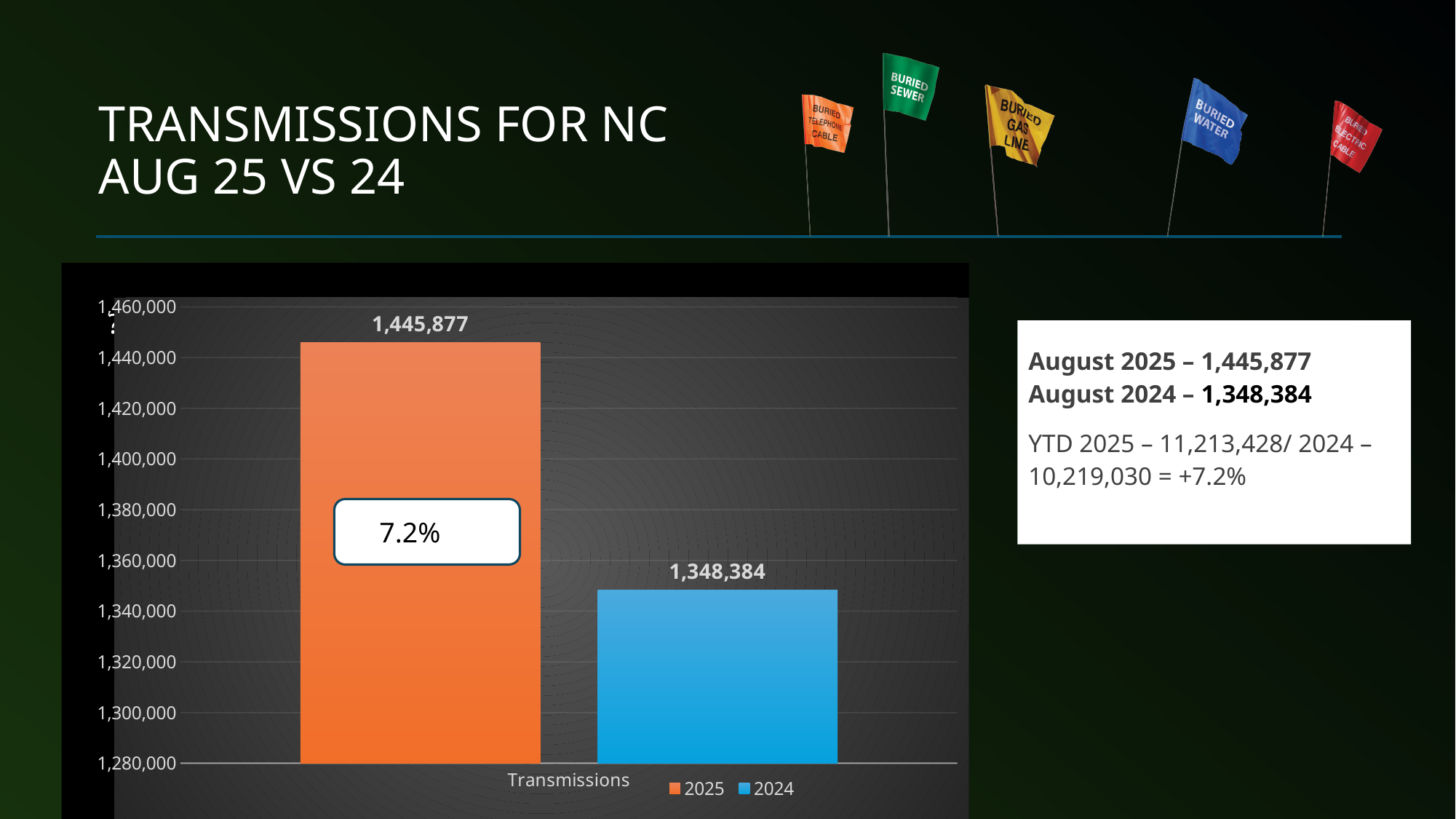
How many series does the legend list? 2 Which series has the higher value for Transmissions, 2025 or 2024? 2025 What percentage is shown in the white box on the 2025 bar? 7.2% What is the value of the 2025 bar for Transmissions? 1,445,877 Which series has the lower value for Transmissions? 2024 What is the value of the 2024 bar for Transmissions? 1,348,384 Is the value for 2025 greater or less than 1,440,000? greater What kind of chart is shown on the slide? bar chart How many categories are shown on the x axis? 1 What is the difference between the 2025 and 2024 Transmissions values? 97,493 Is the 2024 bar larger or smaller than the 2025 bar? smaller Is the value for 2024 greater or less than 1,400,000? less